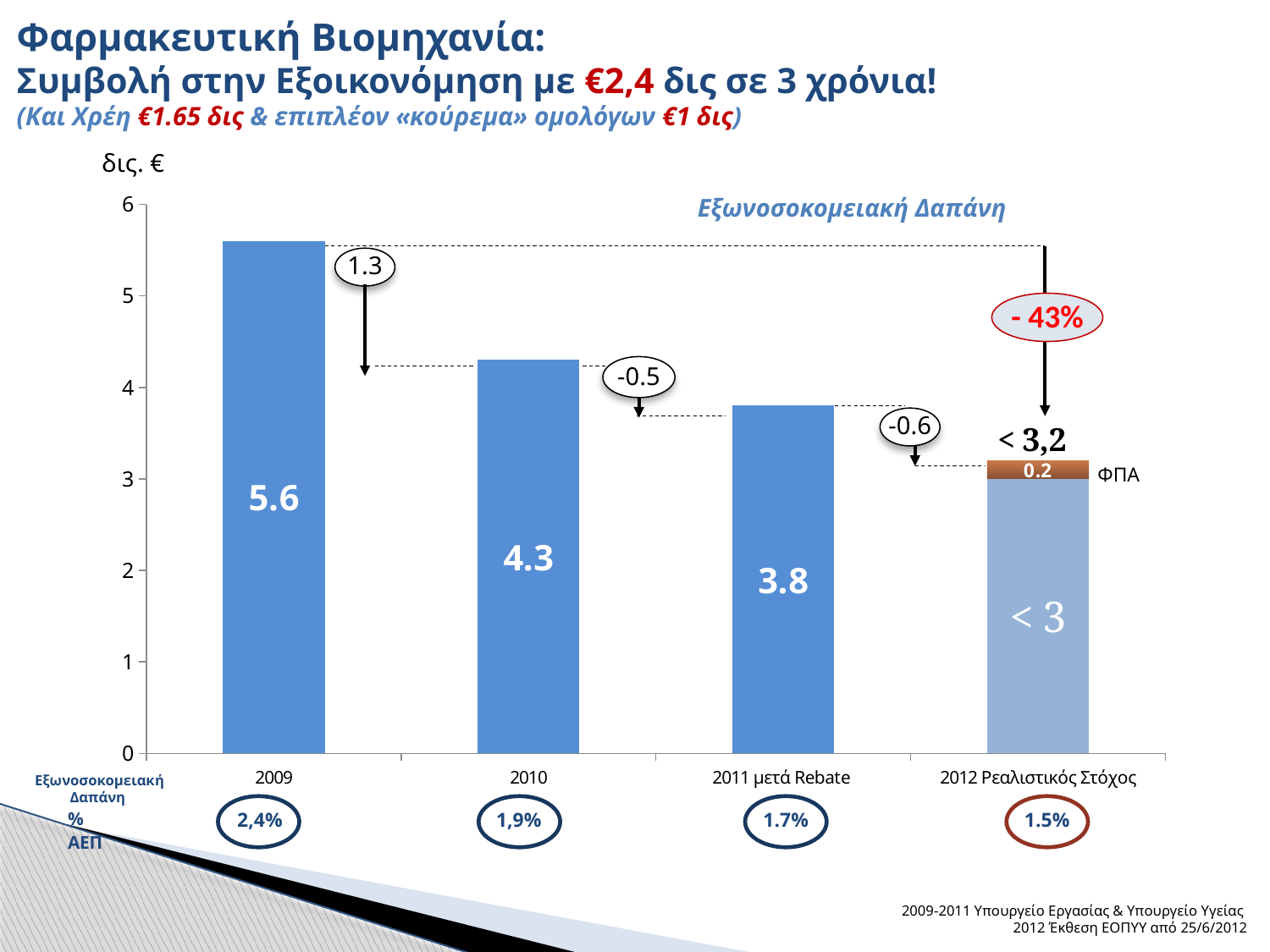
What is the difference between the 2009 value and the 2010 value? 1.3 Is the total value of the 2012 Ρεαλιστικός Στόχος bar greater or less than 4? less How many categories are shown on the x axis? 4 What is the value of the bar for 2009? 5.6 Which is larger, the bar for 2010 or the bar for 2011 μετά Rebate? 2010 What kind of chart is shown on the slide? bar chart What is the value of the bar for 2011 μετά Rebate? 3.8 Which category has the highest bar? 2009 Which category has the lowest bar? 2012 Ρεαλιστικός Στόχος Do the bar values rise or fall from 2009 to 2012? fall What value is labelled on the ΦΠΑ segment of the 2012 Ρεαλιστικός Στόχος bar? 0.2 What is the value of the bar for 2010? 4.3